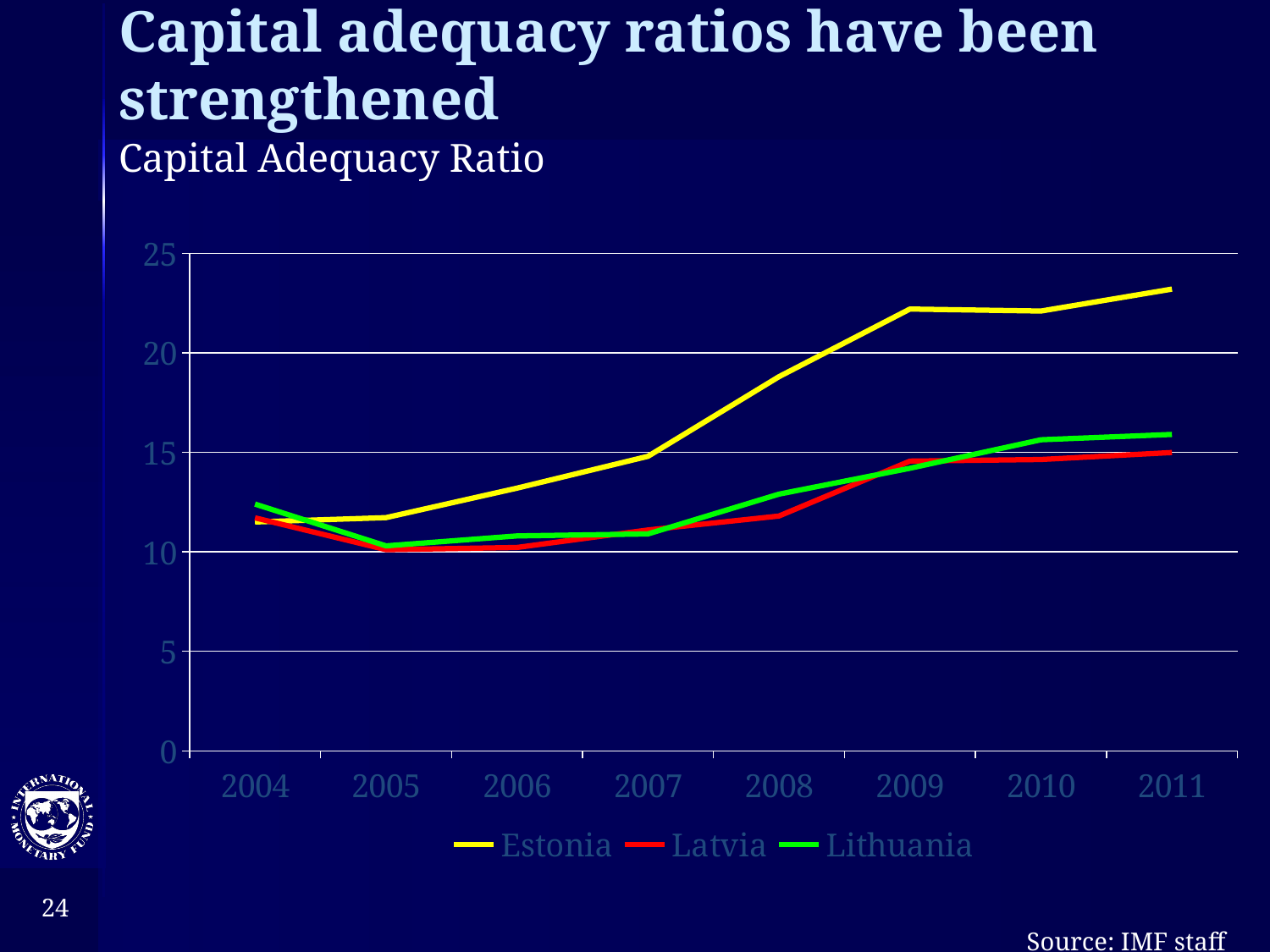
Which country has the highest capital adequacy ratio in 2011? Estonia Is the value for Estonia in 2009 greater or less than 20? greater What is the source cited for the chart? IMF staff Which is higher in 2011, Lithuania or Latvia? Lithuania Is the value for Latvia in 2005 greater or less than 15? less In which year is Estonia's capital adequacy ratio highest? 2011 Does Estonia's capital adequacy ratio rise or fall from 2007 to 2009? rise Which is higher in 2008, Estonia or Latvia? Estonia How many years are shown on the x axis? 8 Is the value for Lithuania in 2008 greater or less than 15? less How many series does the legend list? 3 What type of chart is shown on the slide? line chart